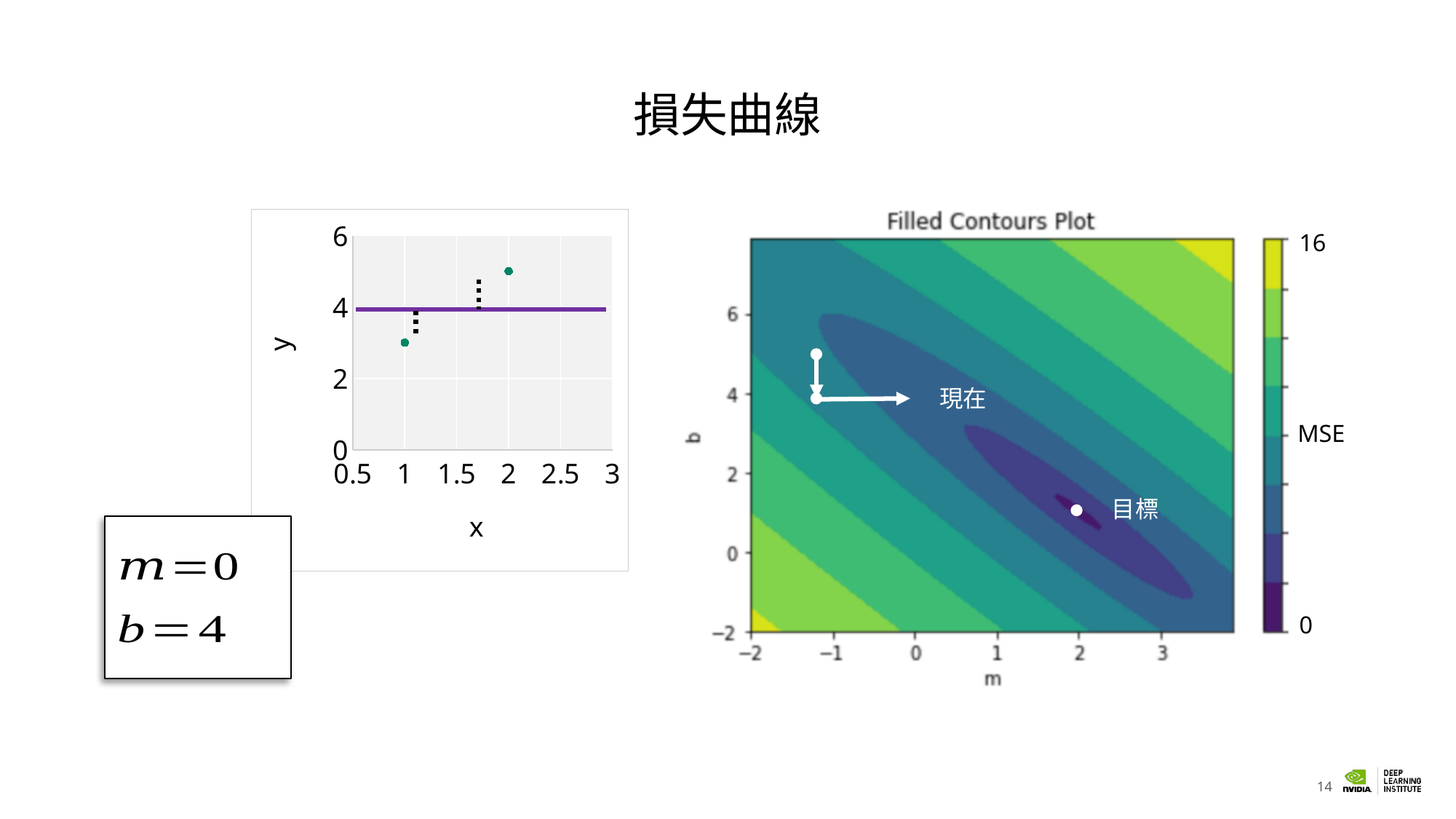
In the scatter plot on the left, do the y values rise or fall as x increases? rise What is the title of the chart on the right of the slide? Filled Contours Plot In the scatter plot on the left, which point has the higher y value, the one at x = 1 or the one at x = 2? x = 2 How many data points are plotted in the scatter plot on the left? 2 In the Filled Contours Plot, what is the maximum value shown on the colour bar? 16 In the Filled Contours Plot, what quantity does the colour bar represent? MSE What kind of chart is the chart on the left of the slide? scatter plot In the scatter plot on the left, at what y value is the horizontal purple line drawn? 4 In the Filled Contours Plot, what is the minimum value shown on the colour bar? 0